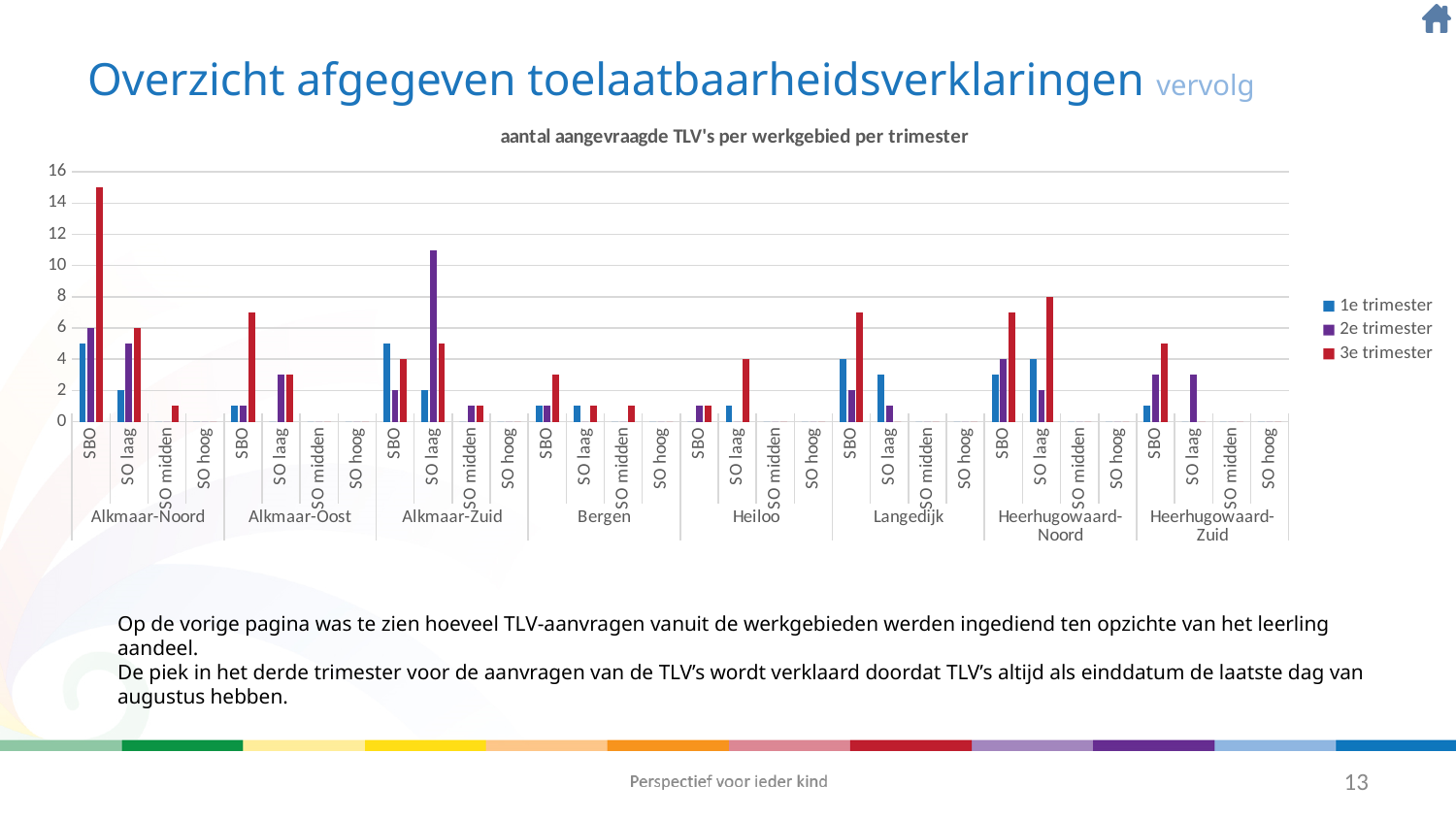
What is the title of the chart? aantal aangevraagde TLV's per werkgebied per trimester Is the 2e trimester value for SO laag in Alkmaar-Zuid greater or less than 10? greater In Alkmaar-Oost, which has the larger 3e trimester value: SBO or SO laag? SBO Is the 3e trimester value for SBO in Alkmaar-Noord greater or less than 14? greater What is the 3e trimester value for SO laag in Heerhugowaard-Noord? 8 How many werkgebieden (region groups) are shown along the x axis? 8 How many series does the legend list? 3 Which is larger: the 3e trimester value for SBO in Alkmaar-Noord or the 2e trimester value for SO laag in Alkmaar-Zuid? 3e trimester for SBO in Alkmaar-Noord What type of chart is shown on the slide? bar chart Which bar is the highest in the whole chart? 3e trimester for SBO in Alkmaar-Noord Is the 3e trimester value for SBO in Langedijk greater or less than 6? greater What are the three series named in the legend? 1e trimester, 2e trimester, 3e trimester